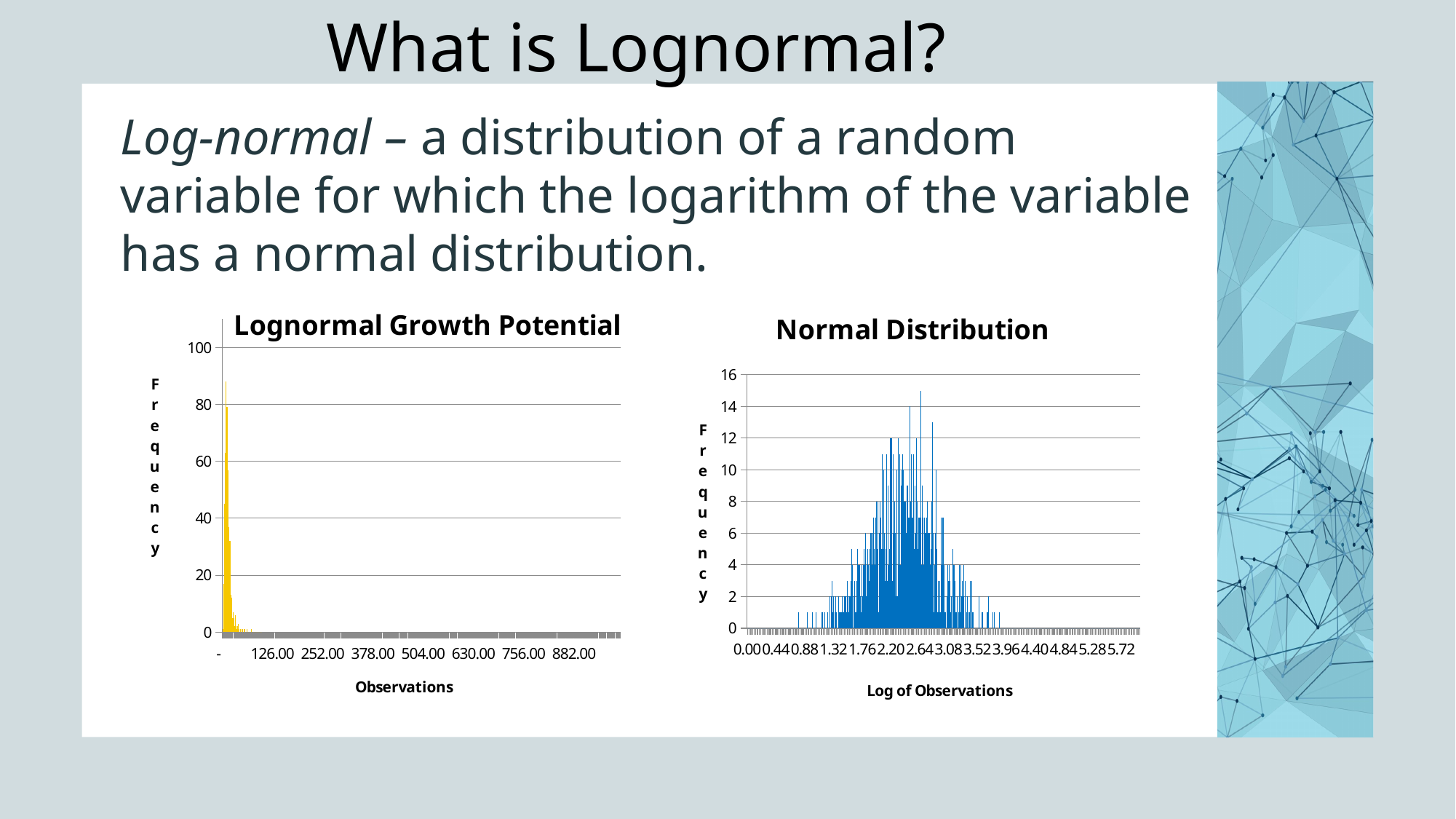
In the Lognormal Growth Potential chart, is the frequency at 504.00 greater or less than 20? less In the Normal Distribution chart, is the tallest bar greater or less than 12? greater In the Lognormal Growth Potential chart, is the tallest bar greater or less than 100? less Which chart has the higher peak frequency, Lognormal Growth Potential or Normal Distribution? Lognormal Growth Potential What kind of chart is the Lognormal Growth Potential chart? bar chart What colour are the bars in the Lognormal Growth Potential chart? yellow What is the x-axis label of the Normal Distribution chart? Log of Observations What kind of chart is the Normal Distribution chart? bar chart